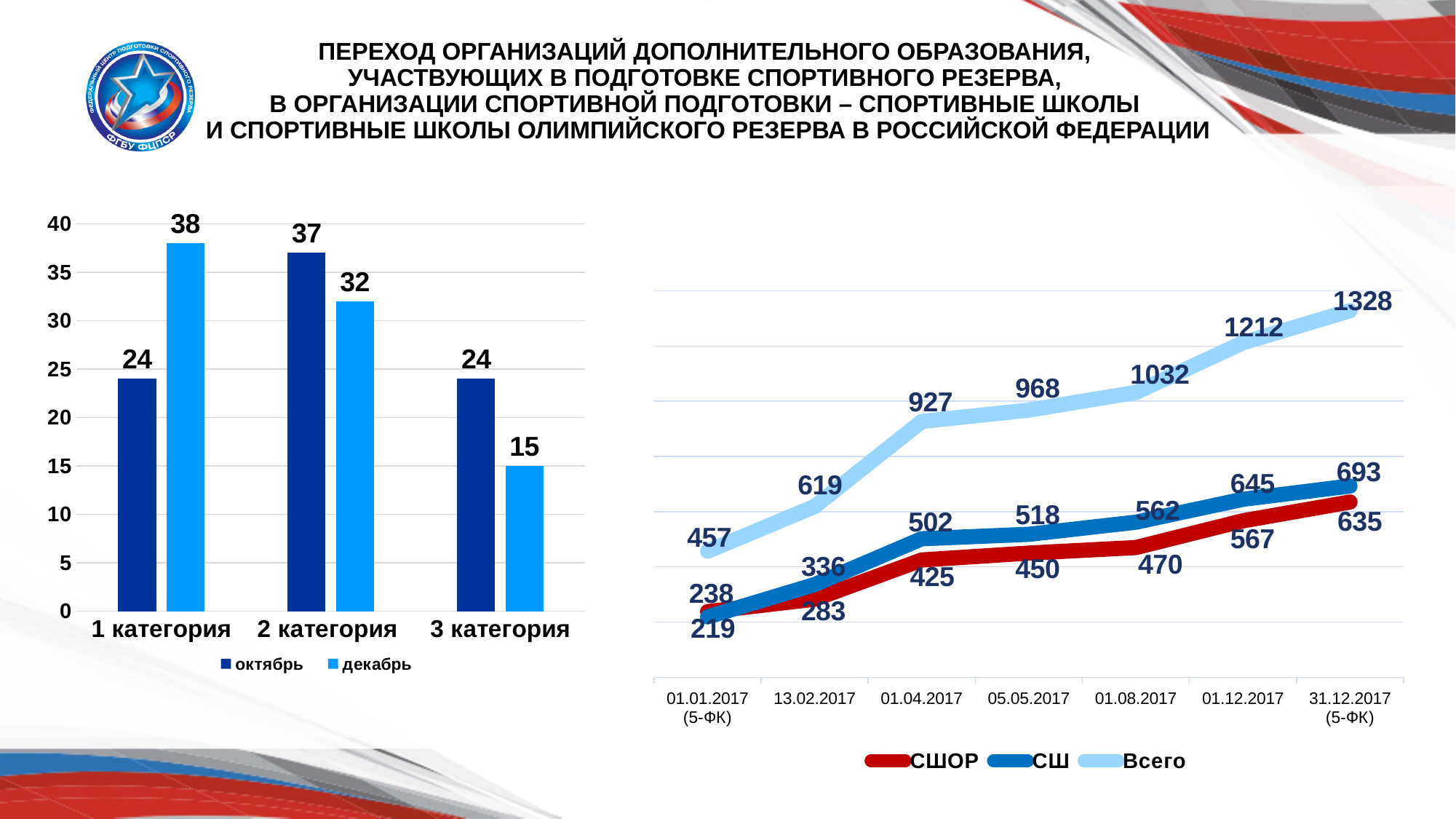
In the line chart on the right, which series is shown in red? СШОР In the bar chart on the left, what kind of chart is it? bar chart In the line chart on the right, what is the difference between СШ and СШОР on 01.12.2017? 78 In the bar chart on the left, which category has the highest декабрь value? 1 категория In the bar chart on the left, how many series does the legend list? 2 In the line chart on the right, what is the value of Всего on 31.12.2017 (5-ФК)? 1328 In the line chart on the right, does the Всего series rise or fall from 01.01.2017 to 31.12.2017? rise In the line chart on the right, how many dates are shown on the x axis? 7 In the bar chart on the left, what is the value for октябрь in 2 категория? 37 In the bar chart on the left, what is the value for декабрь in 3 категория? 15 In the line chart on the right, what is the value of СШОР on 01.04.2017? 425 In the bar chart on the left, what is the difference between the декабрь and октябрь values for 1 категория? 14